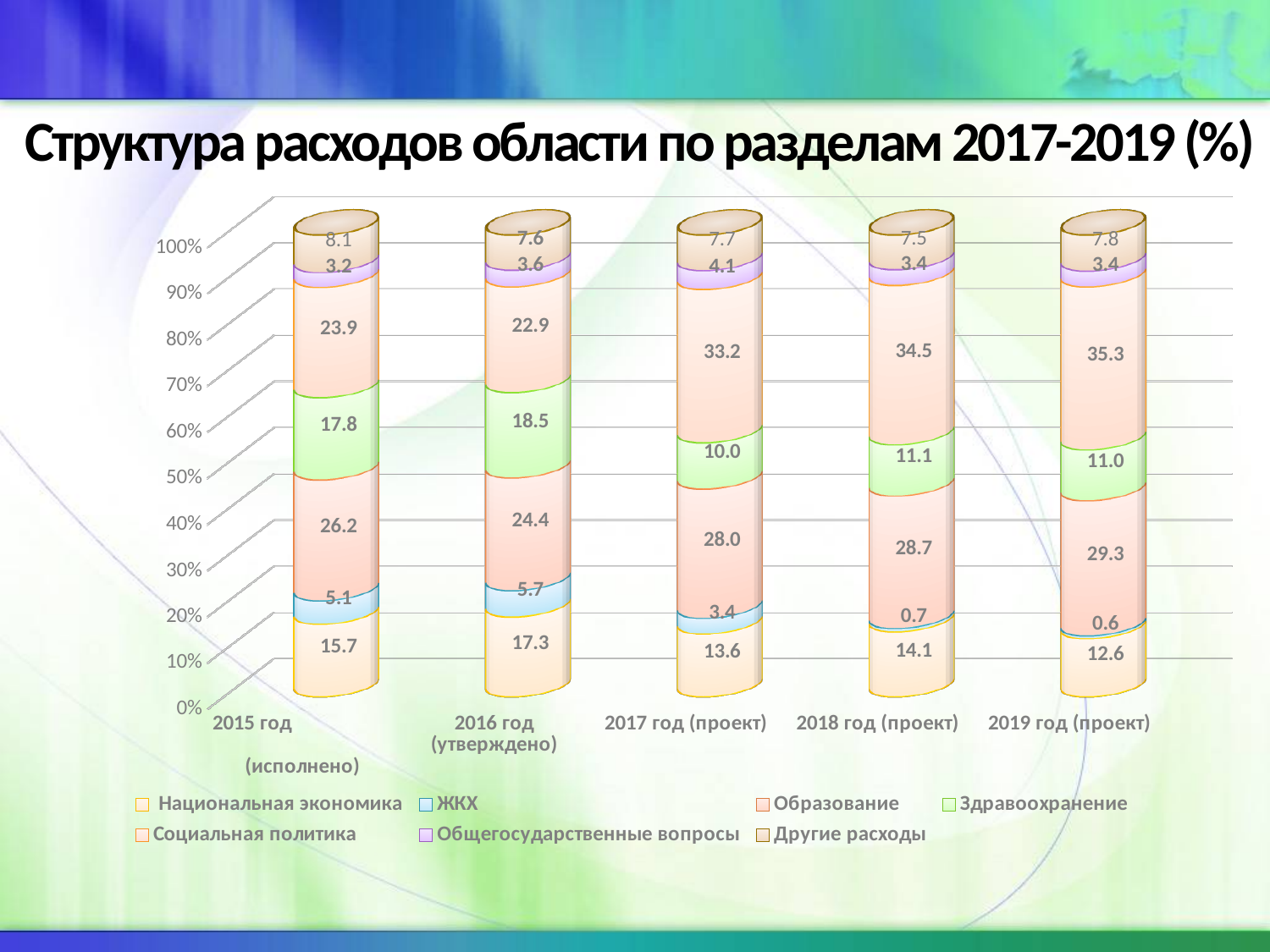
What is the value for ЖКХ in 2018 год (проект)? 0.7 What is the value for Социальная политика in 2019 год (проект)? 35.3 What is the value for Здравоохранение in 2016 год (утверждено)? 18.5 Does the value for Социальная политика rise or fall from 2017 год (проект) to 2019 год (проект)? Rise What is the difference between the Национальная экономика values for 2016 год (утверждено) and 2019 год (проект)? 4.7 Which is larger in 2015 год (исполнено): Образование or Социальная политика? Образование How many series does the legend list? 7 What is the value for Образование in 2017 год (проект)? 28.0 What kind of chart is shown on the slide? Stacked bar chart How many years (categories) are shown on the x axis? 5 In which year is the value for Социальная политика the highest? 2019 год (проект) In which year is the value for ЖКХ the lowest? 2019 год (проект)